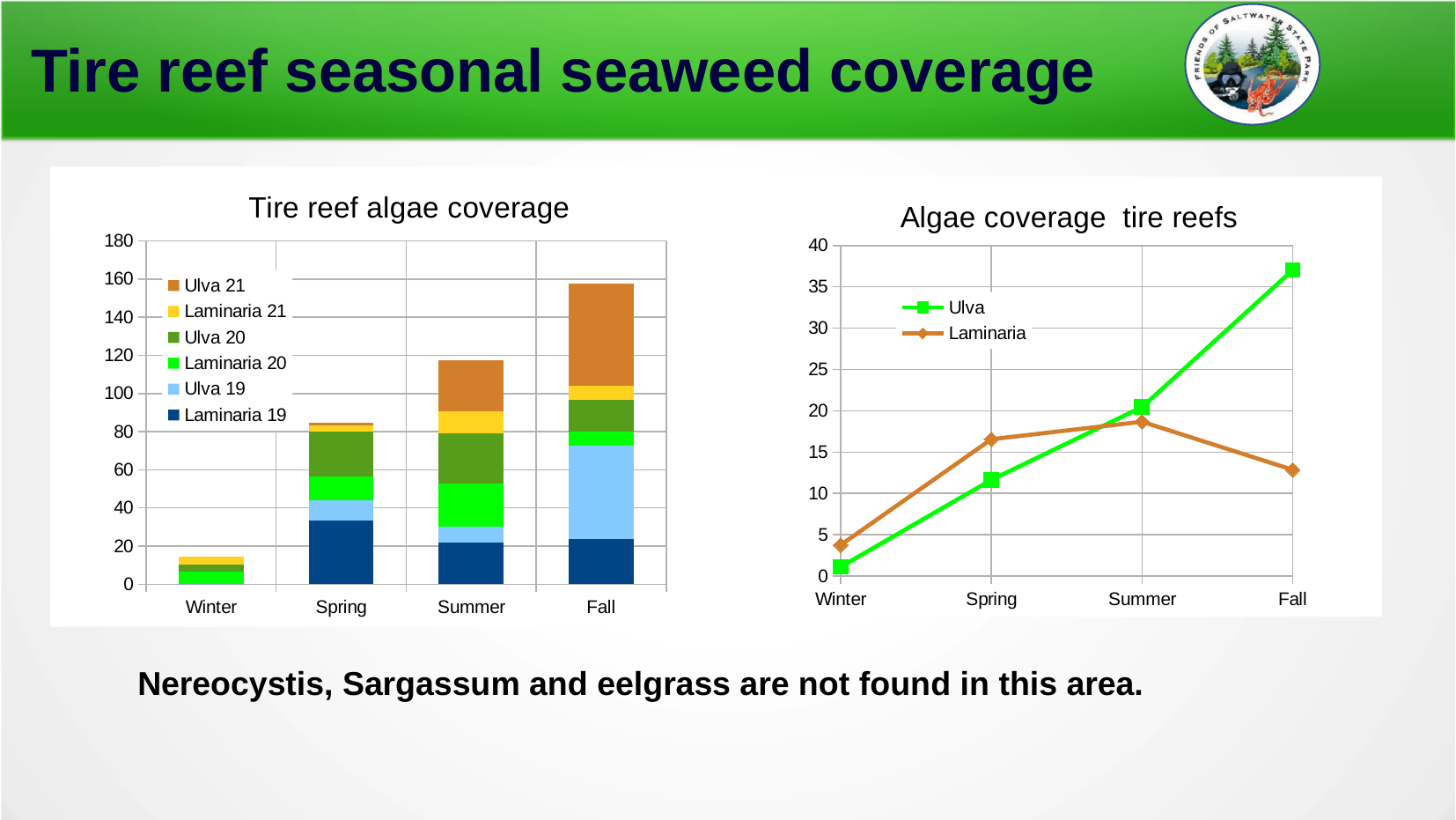
In the 'Tire reef algae coverage' chart, which season has the tallest stacked bar? Fall In the 'Algae coverage tire reefs' chart, does the Ulva line rise or fall from Winter to Fall? rise In the 'Tire reef algae coverage' chart, which season has the shortest stacked bar? Winter In the 'Tire reef algae coverage' chart, how many series does the legend list? 6 In the 'Algae coverage tire reefs' chart, in which season does Ulva reach its highest value? Fall In the 'Tire reef algae coverage' chart, is the total for Fall greater or less than 140? greater What kind of chart is the 'Tire reef algae coverage' chart on the left? stacked bar chart What kind of chart is the 'Algae coverage tire reefs' chart on the right? line chart In the 'Algae coverage tire reefs' chart, how many categories are shown on the x axis? 4 In the 'Algae coverage tire reefs' chart, is the Ulva value for Fall greater or less than 30? greater In the 'Algae coverage tire reefs' chart, in which season does Laminaria reach its highest value? Summer In the 'Tire reef algae coverage' chart, is the total for Summer greater or less than 100? greater